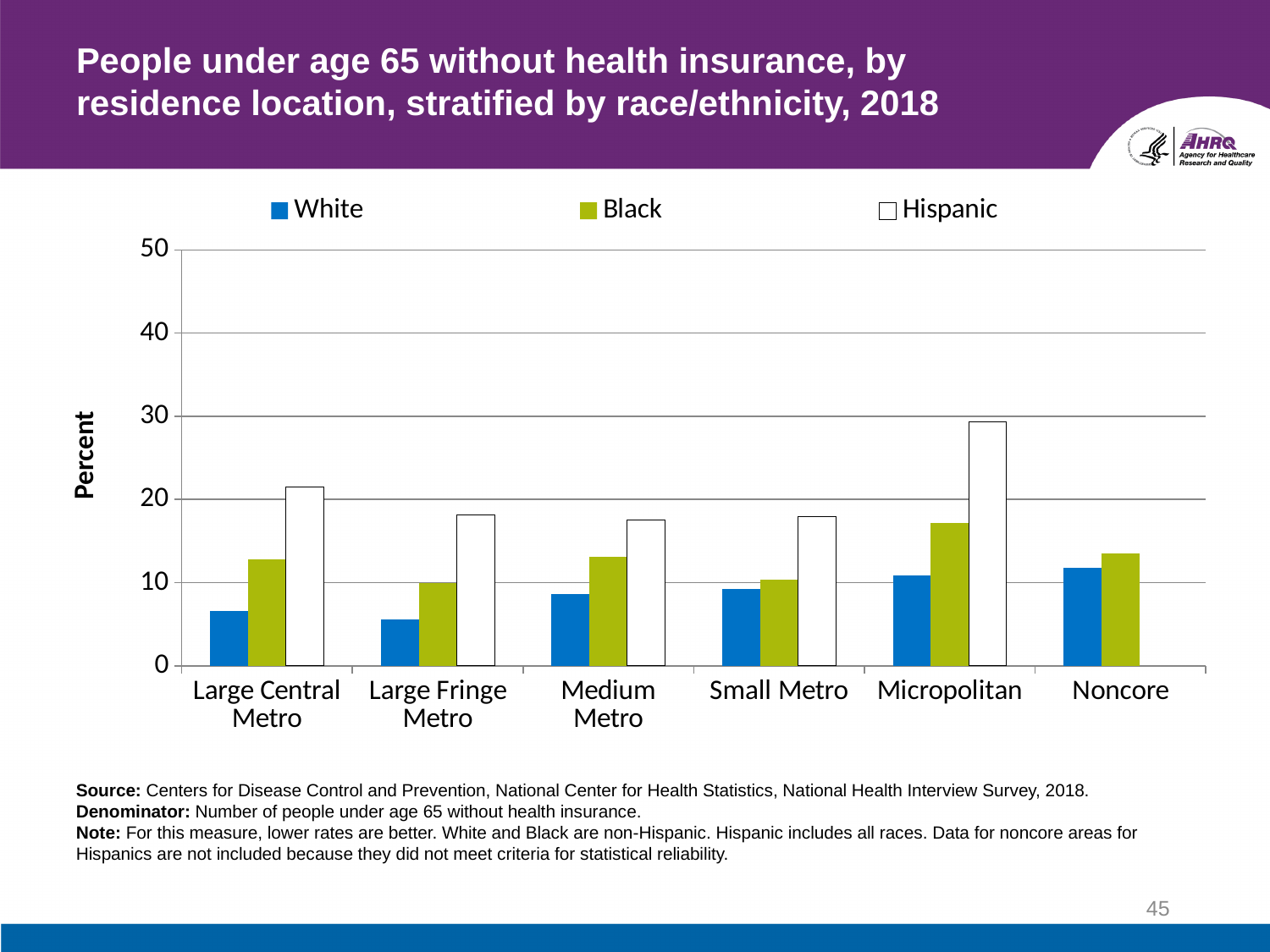
Is the Black value for Micropolitan greater or less than 10? greater What kind of chart is shown on the slide? bar chart For Noncore, which is larger, the White value or the Black value? Black How many residence location categories are shown on the x axis? 6 Which residence location has the highest Hispanic value? Micropolitan For Large Central Metro, which is larger, the Black value or the Hispanic value? Hispanic Is the White value for Large Central Metro greater or less than 10? less Is the Hispanic value for Micropolitan greater or less than 20? greater Does the White series generally rise or fall from Large Fringe Metro to Noncore? rise What is the label on the y axis? Percent How many series does the legend list? 3 Which residence location has the lowest White value? Large Fringe Metro